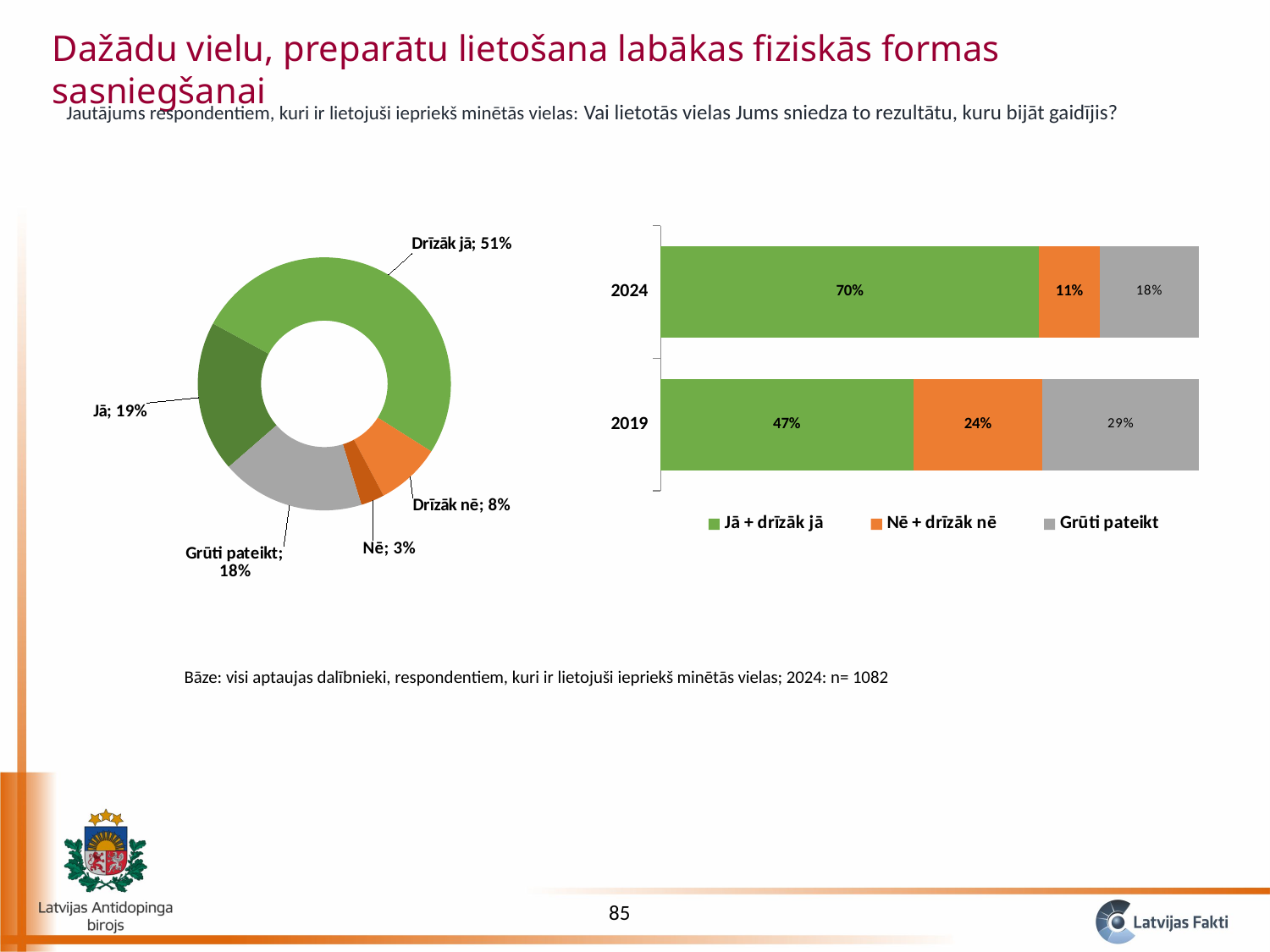
In the doughnut chart on the left, how many slices are there? 5 In the doughnut chart on the left, what share is labelled "Nē"? 3% What kind of chart is shown on the right side of the slide? Stacked bar chart In the stacked bar chart on the right, what is the value of "Jā + drīzāk jā" for 2024? 70% In the doughnut chart on the left, what is the difference between the "Jā" and "Drīzāk nē" shares? 11 percentage points In the stacked bar chart on the right, which year has the larger "Nē + drīzāk nē" value, 2024 or 2019? 2019 In the doughnut chart on the left, what share is labelled "Drīzāk jā"? 51% How many series does the legend of the stacked bar chart on the right list? 3 In the doughnut chart on the left, which slice is the smallest? Nē In the doughnut chart on the left, which slice is the largest? Drīzāk jā In the stacked bar chart on the right, what is the difference between the "Jā + drīzāk jā" values for 2024 and 2019? 23 percentage points In the stacked bar chart on the right, what is the value of "Grūti pateikt" for 2019? 29%